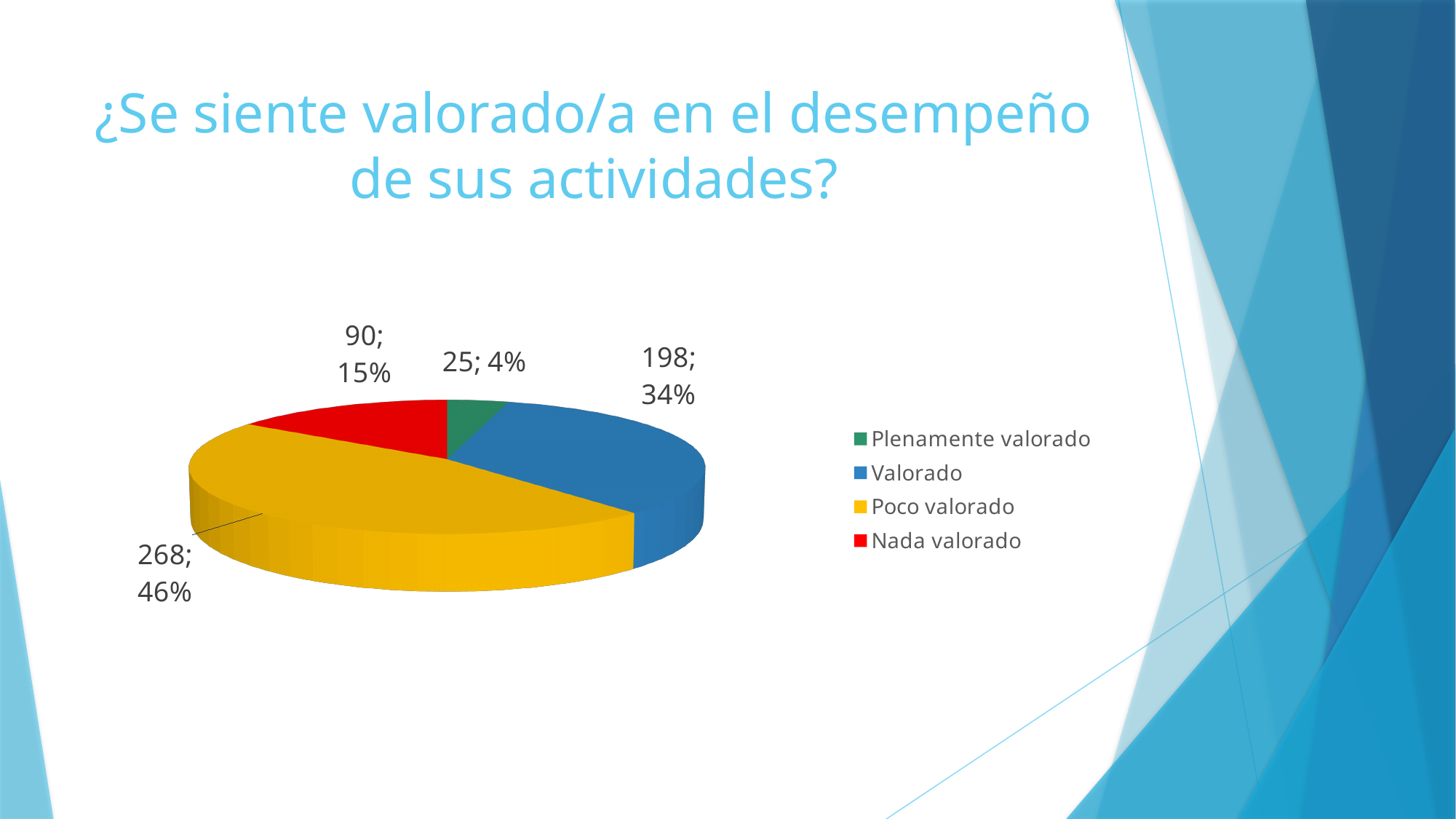
What percentage share does "Nada valorado" have? 15% What colour is the "Valorado" slice? blue How many categories does the pie chart have? 4 What percentage share does "Valorado" have? 34% Which is larger, the count for "Nada valorado" or the count for "Plenamente valorado"? Nada valorado What is the count for "Poco valorado"? 268 Which category has the largest slice? Poco valorado What is the count for "Plenamente valorado"? 25 What is the total of all four counts shown on the pie chart? 581 What is the difference between the counts for "Poco valorado" and "Valorado"? 70 What kind of chart is shown on the slide? pie chart Which category has the smallest slice? Plenamente valorado